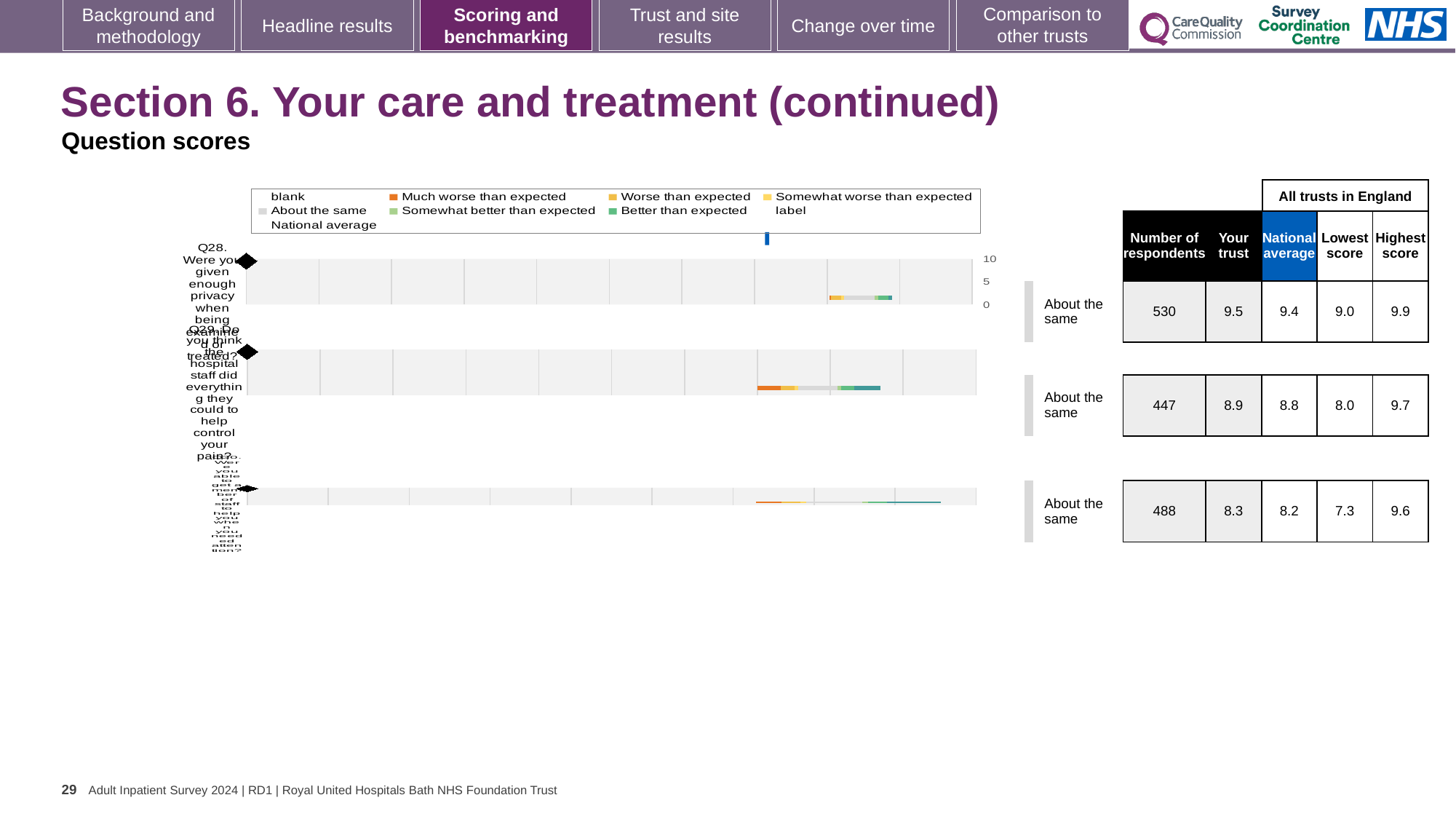
Which question has the lowest number of respondents? Q29 How many questions are charted on this slide? 3 Which question has the highest 'Your trust' score on this slide? Q28 What is the difference between the 'Your trust' score and the national average for Q28? 0.1 What is the highest score among all trusts in England for Q28? 9.9 What is the lowest score among all trusts in England for Q30? 7.3 Which has the larger 'Your trust' score, Q28 or Q29? Q28 How many respondents answered Q28 (Were you given enough privacy when being examined or treated?)? 530 What is the national average score for Q30 (Were you able to get a member of staff to help you when you needed attention?)? 8.2 What is the difference between the highest and lowest scores among all trusts in England for Q30? 2.3 What benchmark category is shown for Q29? About the same What is the 'Your trust' score for Q29 (Do you think the hospital staff did everything they could to help control your pain?)? 8.9